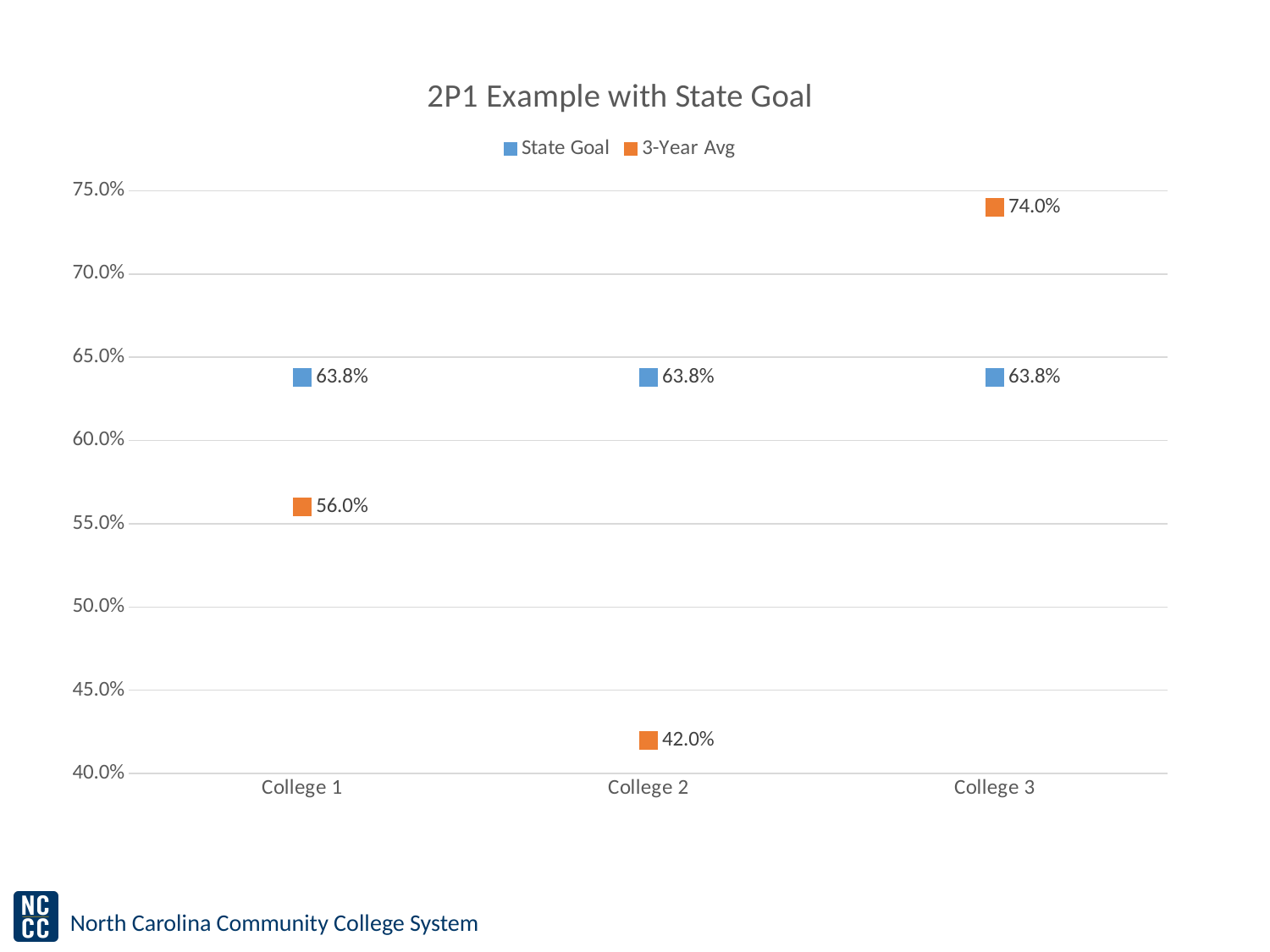
What is the 3-Year Avg value for College 2? 42.0% Which college has the highest 3-Year Avg? College 3 Which is larger for College 1: the State Goal or the 3-Year Avg? State Goal What is the difference between the 3-Year Avg for College 3 and the State Goal? 10.2% What is the 3-Year Avg value for College 1? 56.0% Which college has the lowest 3-Year Avg? College 2 What is the 3-Year Avg value for College 3? 74.0% How many series does the legend list? 2 How many colleges are shown on the x axis? 3 What is the title of the chart? 2P1 Example with State Goal What is the difference between the State Goal and the 3-Year Avg for College 2? 21.8% What is the State Goal value for College 2? 63.8%